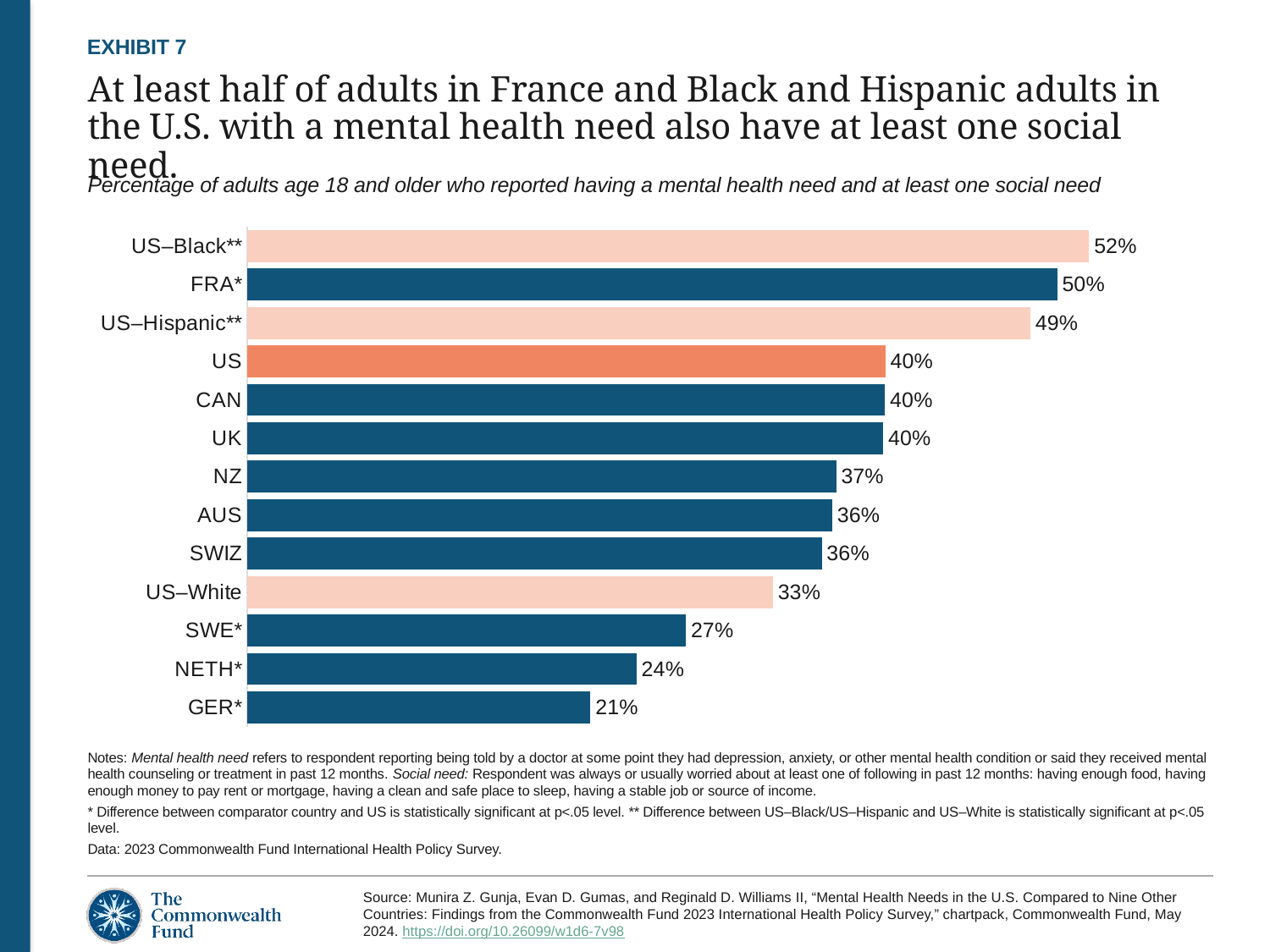
Which is larger, the value for NZ or the value for SWE*? NZ What is the value for FRA*? 50% What kind of chart is shown on the slide? Bar chart What is the value for NETH*? 24% What is the difference between the values for SWE* and GER*? 6% What is the value for US–Hispanic**? 49% Which category has the highest value? US–Black** How many categories are shown in the chart? 13 What is the difference between the values for US–Black** and US–White? 19% What is the value for US–White? 33% Which bar is shown in a darker orange colour than the other US subgroup bars? US Which category has the lowest value? GER*